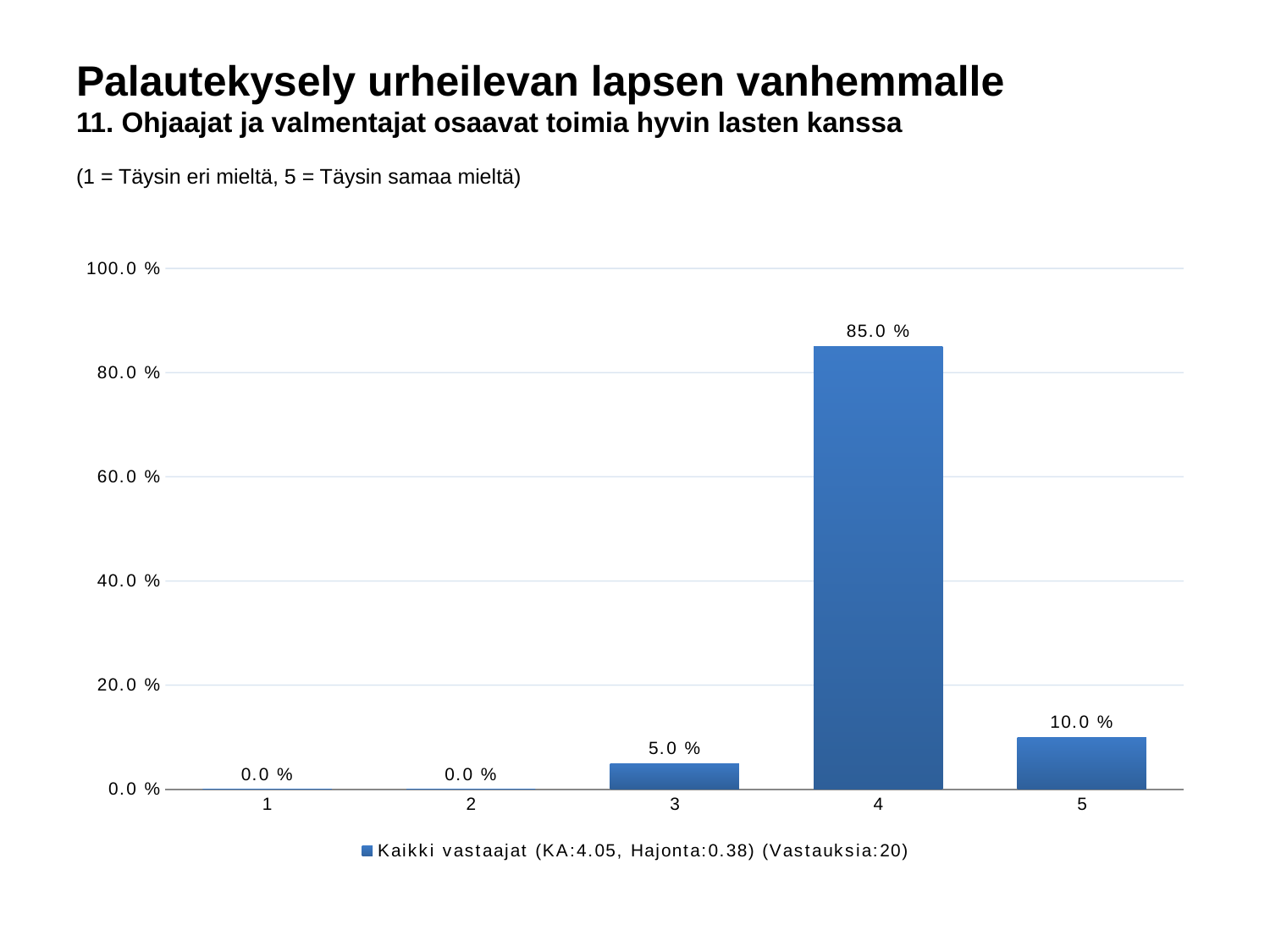
What kind of chart is shown? bar chart What is the difference between the values for category 4 and category 5? 75.0 % What is the value for category 4? 85.0 % Is the value for category 4 greater or less than 80.0 %? greater How many series does the legend list? 1 How many responses (Vastauksia) does the legend report? 20 Which is larger, the value for category 3 or category 5? 5 What is the value for category 1? 0.0 % What is the value for category 5? 10.0 % Which category has the highest value? 4 How many categories are shown on the x axis? 5 What is the value for category 3? 5.0 %